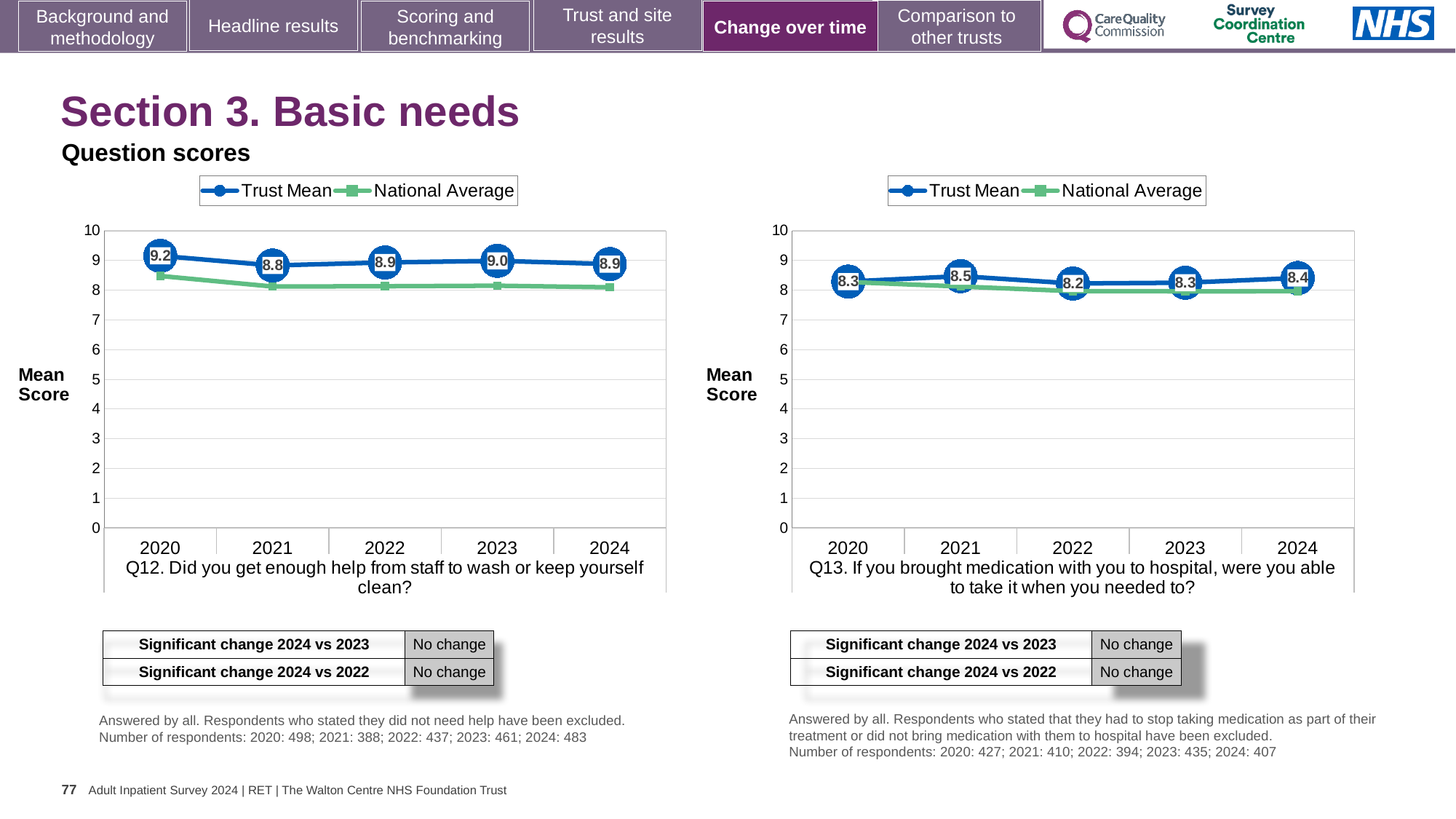
In the Q12 chart on the left, which year has the lowest Trust Mean? 2021 How many years are shown on the x axis of the Q13 chart on the right? 5 In the Q12 chart on the left, which year has the highest Trust Mean? 2020 In the Q12 chart on the left, what is the difference between the Trust Mean in 2020 and in 2021? 0.4 In the Q13 chart on the right, is the Trust Mean higher in 2021 or in 2022? 2021 In the Q12 chart on the left, what is the Trust Mean for 2020? 9.2 In the Q13 chart on the right, which year has the lowest Trust Mean? 2022 In the Q12 chart on the left, is the National Average for 2021 greater or less than 9? less In the Q13 chart on the right, does the Trust Mean rise or fall from 2022 to 2024? Rise What type of chart is the Q13 chart on the right? Line chart In the Q13 chart on the right, what is the Trust Mean for 2021? 8.5 How many series does the legend of the Q12 chart on the left list? 2